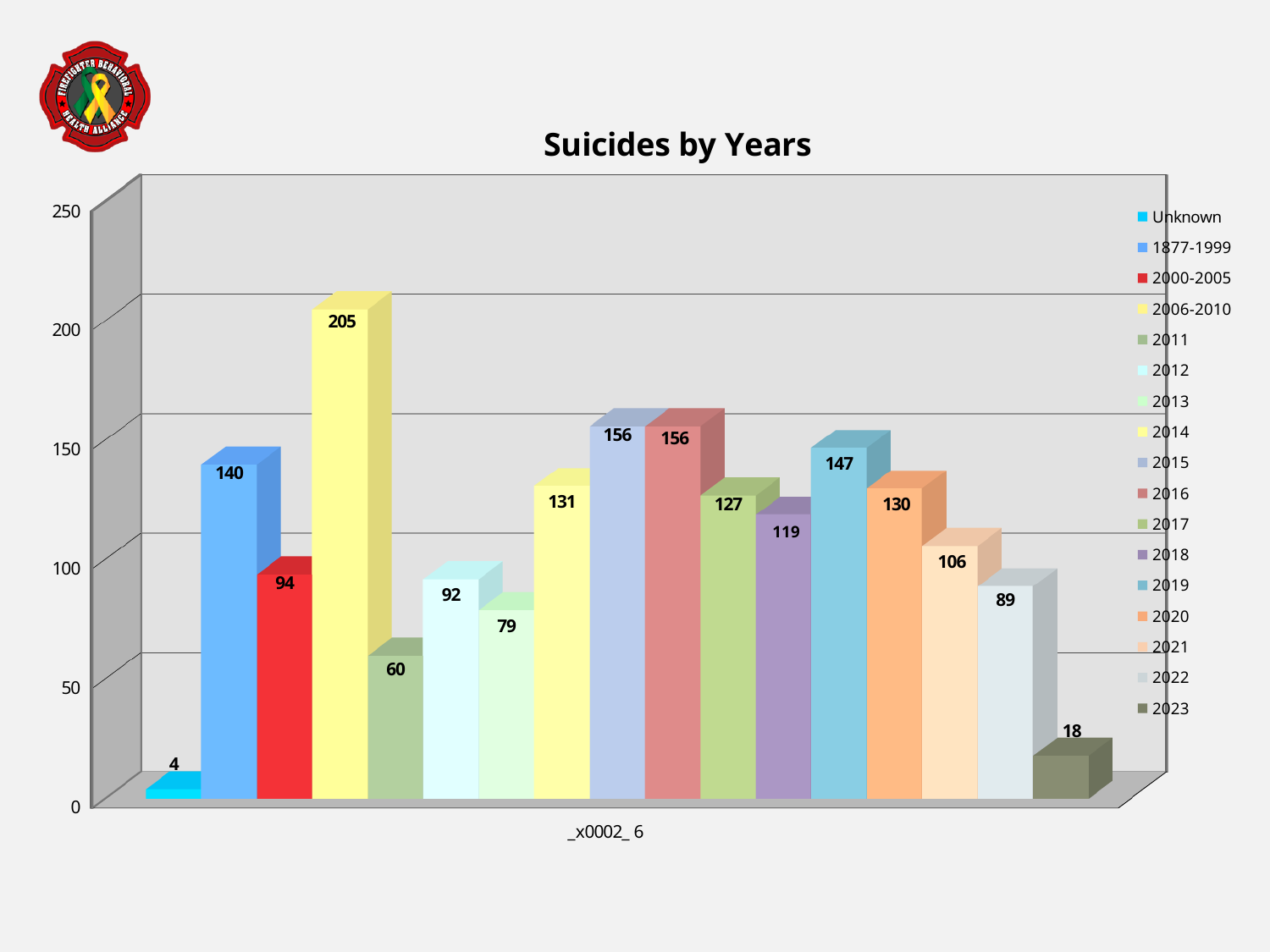
How many entries does the legend list? 17 Which is larger, the value for 2012 or the value for 2013? 2012 Which legend entry has the highest value? 2006-2010 What kind of chart is shown on the slide? bar chart What is the difference between the values for 2014 and 2011? 71 Which legend entry has the lowest value? Unknown What is the value for 2006-2010? 205 What is the value for 2019? 147 What is the difference between the values for 1877-1999 and 2000-2005? 46 What is the value for 2023? 18 What is the title of the chart? Suicides by Years Which is larger, the value for 2017 or the value for 2018? 2017